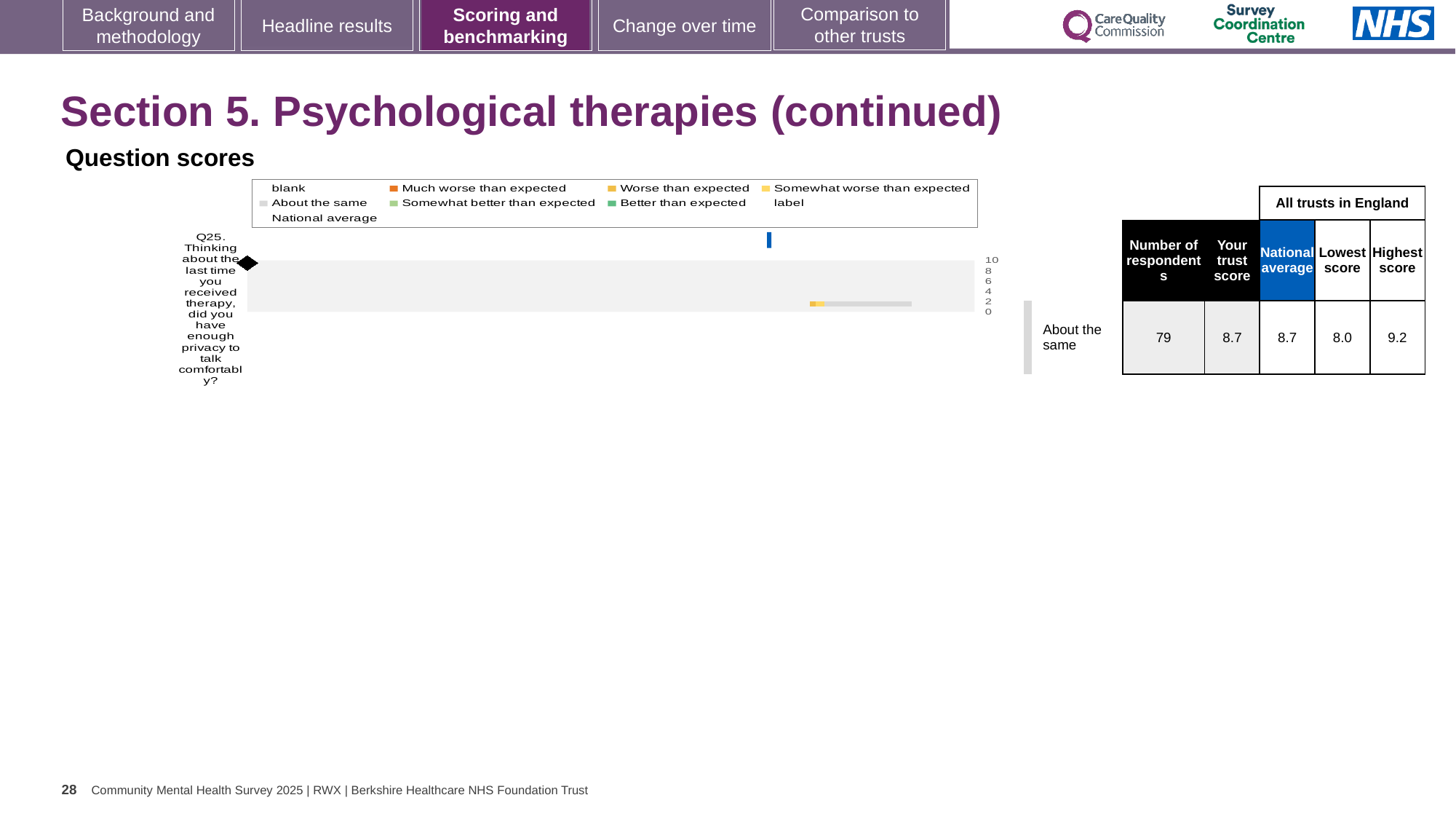
What is the lowest score among all trusts in England for Q25? 8.0 What benchmark category is shown for Q25 next to the chart? About the same What is the difference between the highest score and the lowest score for Q25? 1.2 Which question is plotted in the Question scores chart? Q25. Thinking about the last time you received therapy, did you have enough privacy to talk comfortably? How many respondents answered Q25? 79 What kind of chart is shown under 'Question scores'? bar chart How many questions are plotted in the Question scores chart? 1 What is the maximum value shown on the chart's score axis? 10 Which is larger for Q25, the highest score or the lowest score? Highest score What is the national average score for Q25? 8.7 What is the trust score for Q25? 8.7 What is the highest score among all trusts in England for Q25? 9.2